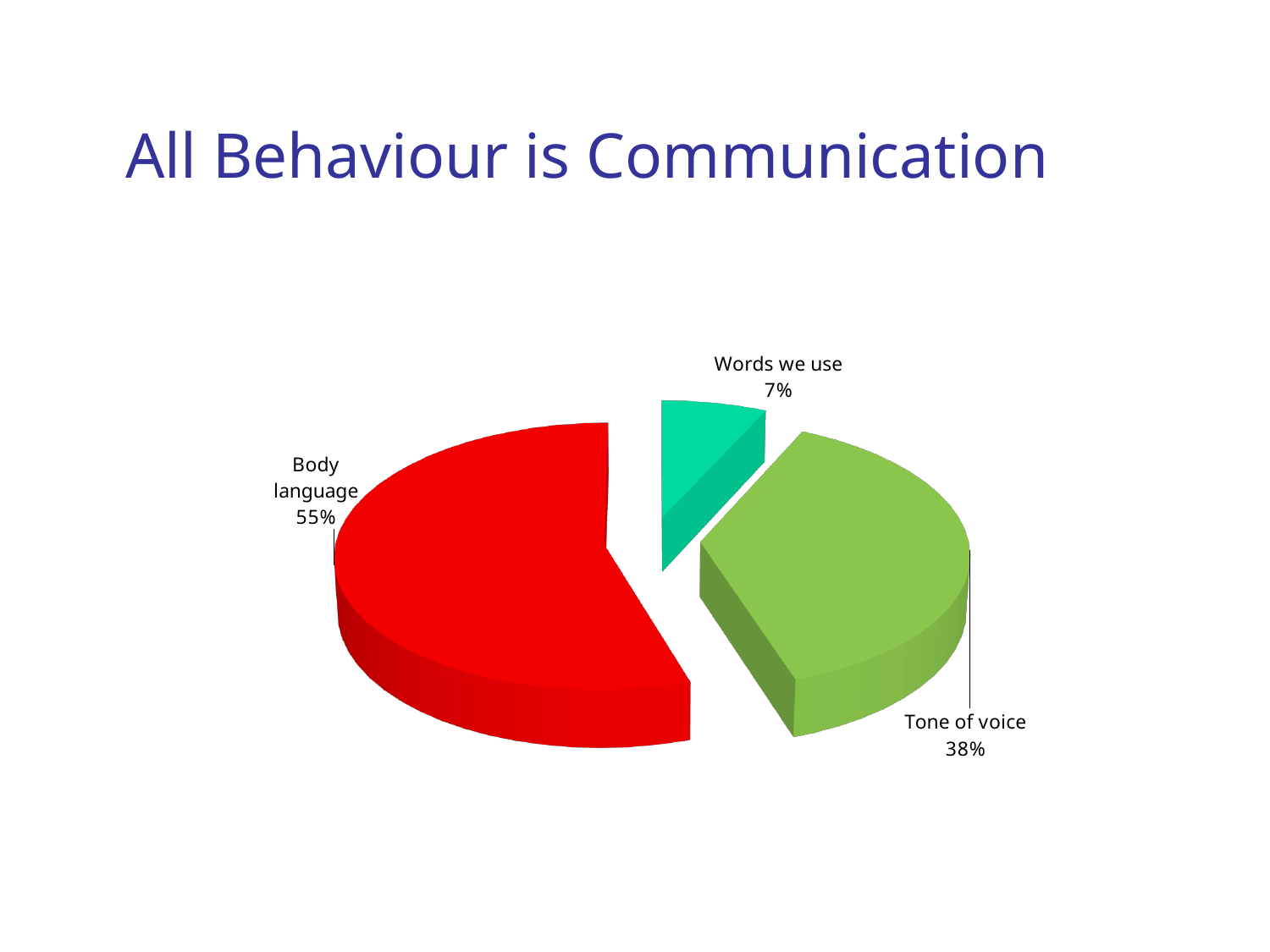
Which slice of the pie is the smallest? Words we use Which is larger, Tone of voice or Words we use? Tone of voice What share of the pie does Words we use take? 7% What is the title of the slide containing the pie chart? All Behaviour is Communication What share of the pie does Tone of voice take? 38% Which slice of the pie is the largest? Body language What kind of chart is shown on the slide? pie chart What share of the pie does Body language take? 55% What is the difference in percentage points between Tone of voice and Words we use? 31 What colour is the Body language slice? red How many slices does the pie chart have? 3 What is the difference in percentage points between Body language and Tone of voice? 17